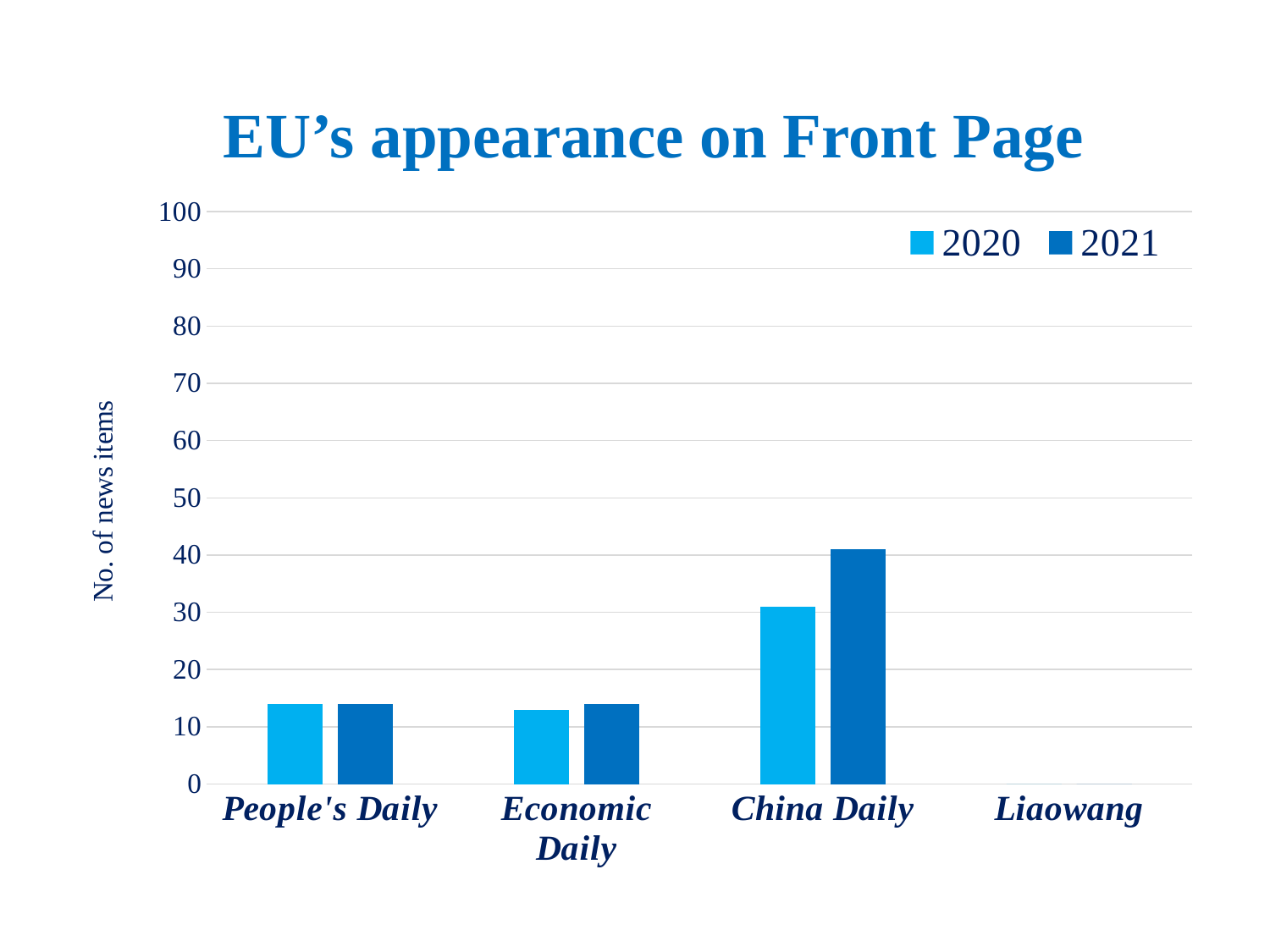
Which category has the highest value for 2021? China Daily Which category has the lowest values for both 2020 and 2021? Liaowang What is the label of the vertical axis? No. of news items Is the value for Economic Daily in 2020 greater or less than 20? less What kind of chart is shown on the slide? bar chart What is the title of the chart? EU's appearance on Front Page How many series does the legend list? 2 Which category has the highest value for 2020? China Daily For China Daily, which year has the larger value, 2020 or 2021? 2021 How many categories are shown on the x axis? 4